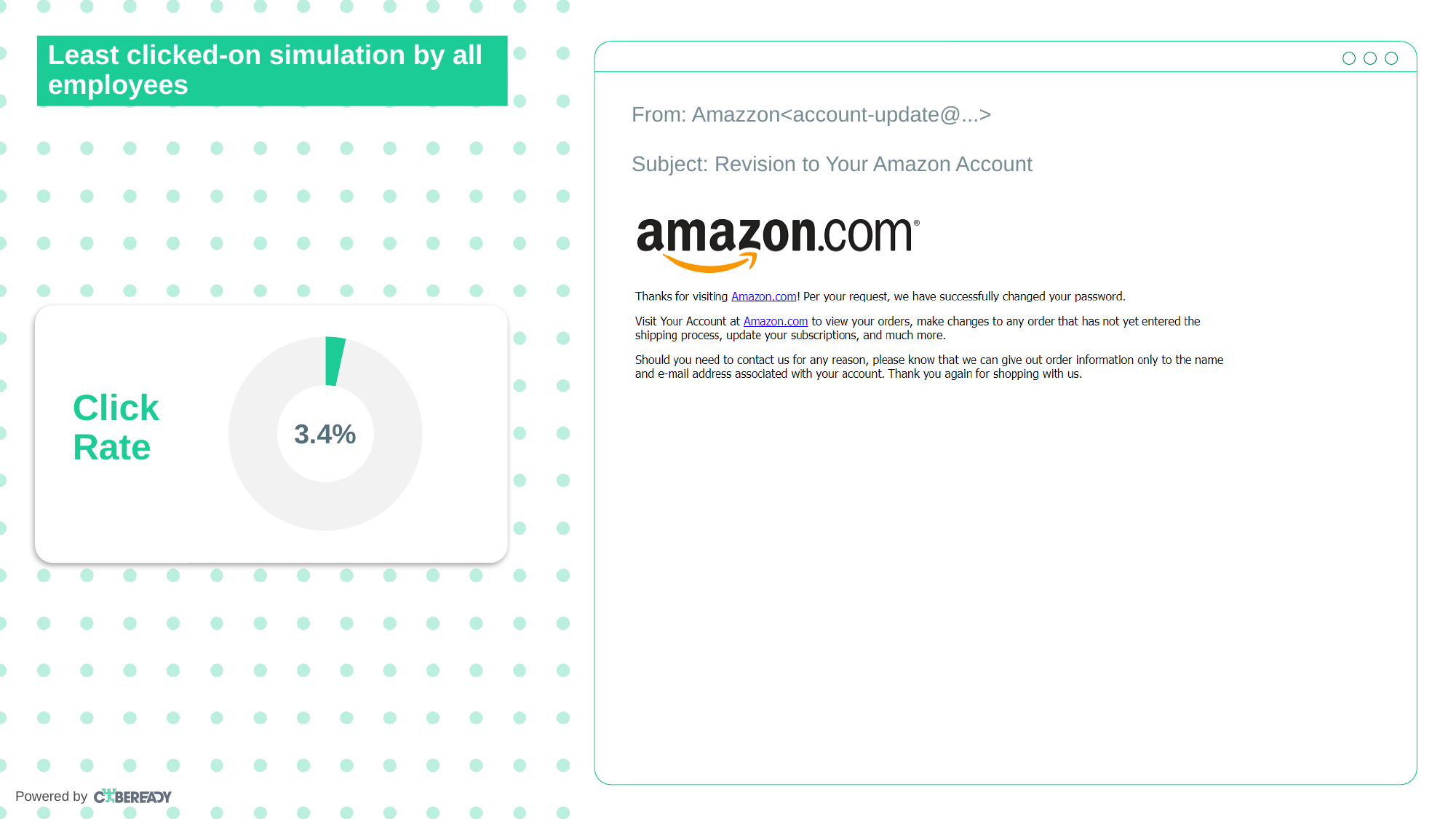
What metric is labelled next to the donut chart? Click Rate What kind of chart is used to display the click rate? Donut (pie) chart What share of the donut chart does the green slice represent? 3.4% What colour is the highlighted slice of the donut chart? Green How many data values are printed on the donut chart? 1 What click rate does the donut chart show? 3.4% Which is larger in the donut chart: the green highlighted slice or the grey remainder? The grey remainder